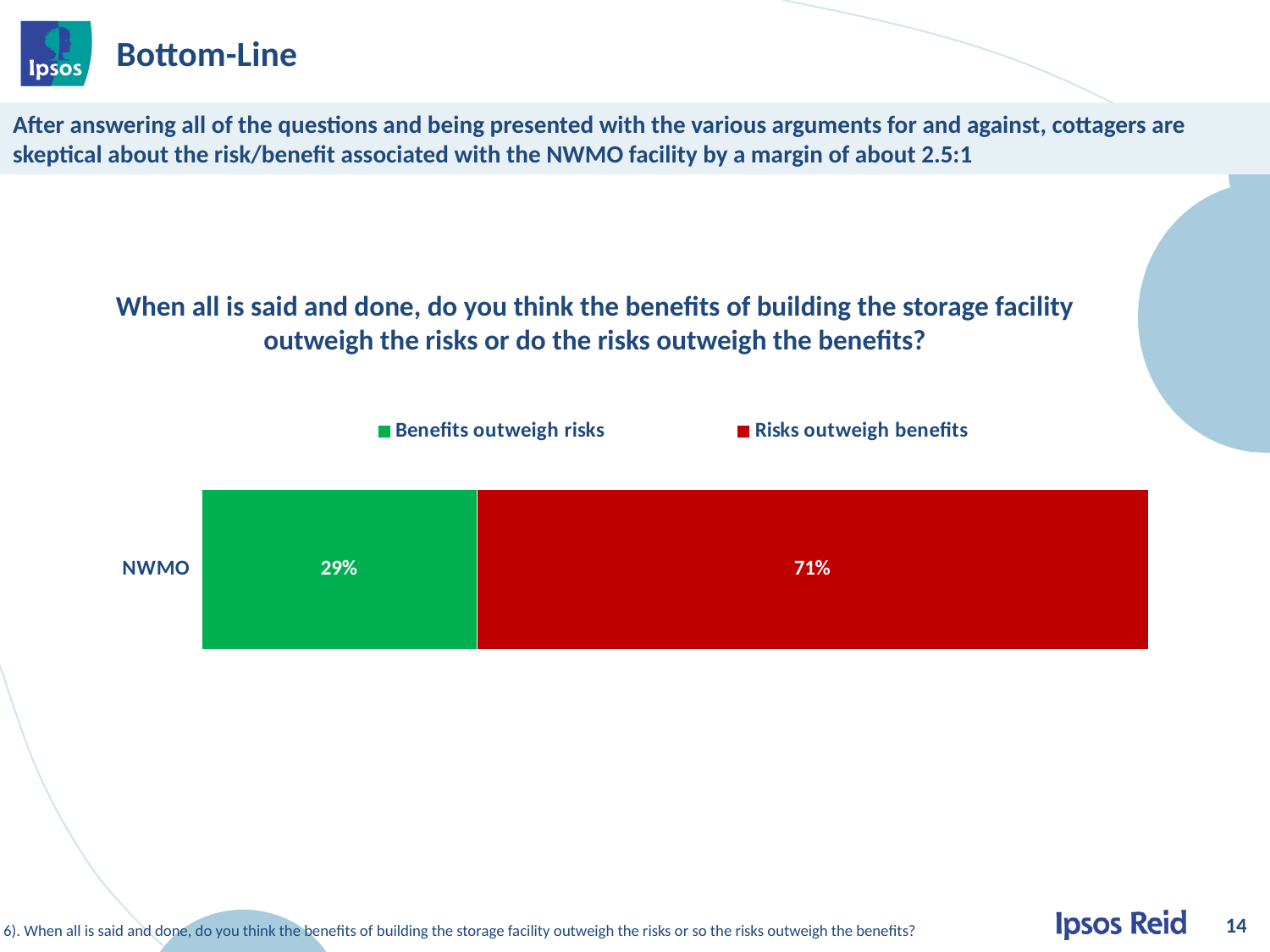
Which series has the highest value in the chart? Risks outweigh benefits How many categories are plotted on the chart? 1 What percentage of NWMO respondents said risks outweigh benefits? 71% How many series does the legend list? 2 What colour represents 'Benefits outweigh risks' in the chart? Green What is the label of the category shown on the chart's axis? NWMO What kind of chart is shown on the slide? Stacked bar chart Which response is larger for NWMO: 'Benefits outweigh risks' or 'Risks outweigh benefits'? Risks outweigh benefits What percentage of NWMO respondents said benefits outweigh risks? 29% What is the difference between the 'Risks outweigh benefits' and 'Benefits outweigh risks' percentages for NWMO? 42% What is the total of the two segments in the NWMO bar? 100% Which series has the lowest value in the chart? Benefits outweigh risks